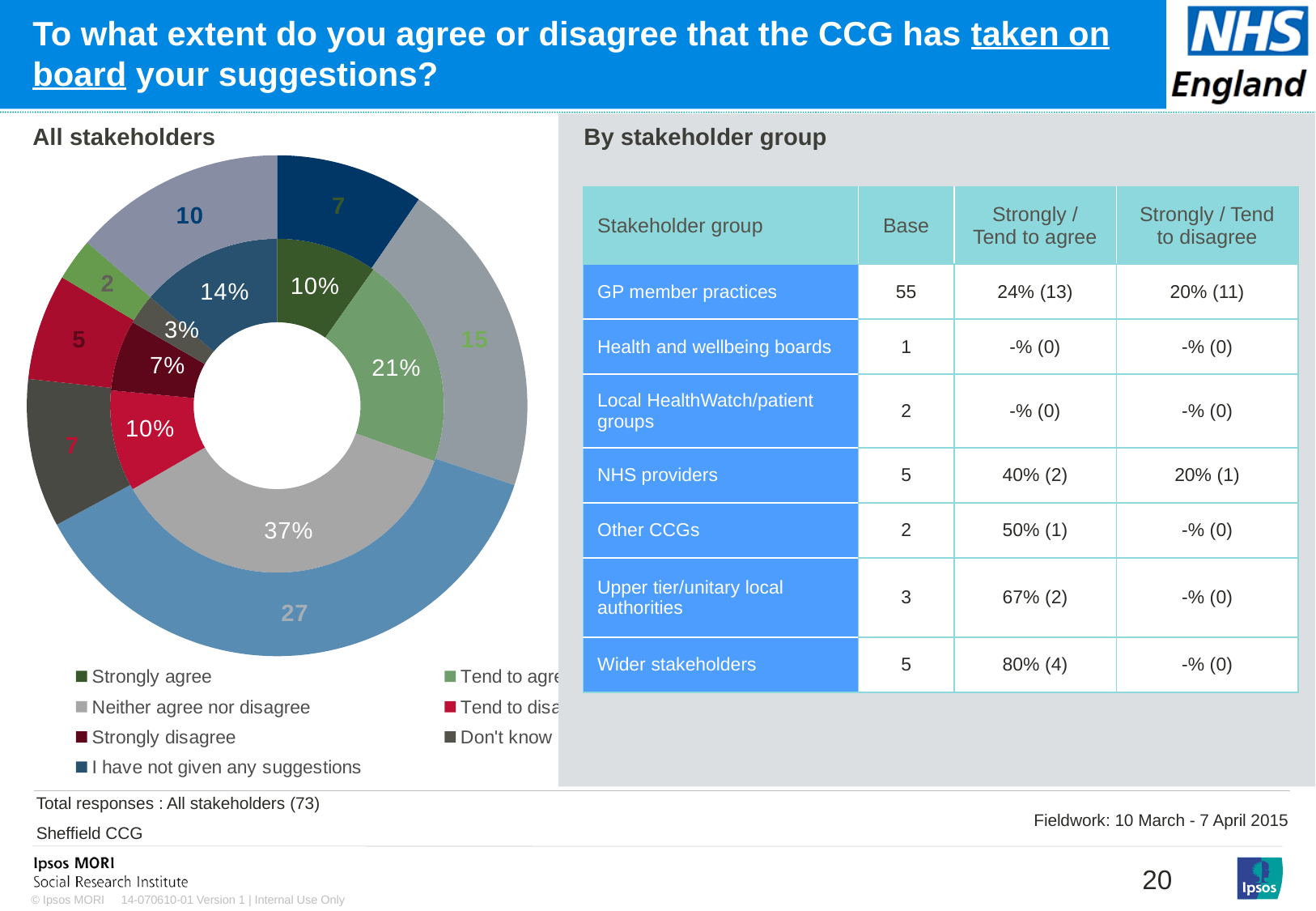
What is the total number of responses stated for the 'All stakeholders' chart? 73 In the 'All stakeholders' chart, which response category has the largest share? Neither agree nor disagree In the 'All stakeholders' chart, what is the difference in percentage points between 'Neither agree nor disagree' and 'Tend to agree'? 16 How many response categories does the legend of the 'All stakeholders' chart list? 7 In the 'All stakeholders' chart, what percentage of respondents said 'Strongly disagree'? 7% In the 'All stakeholders' chart, which response category has the smallest share? Don't know What type of chart is shown under 'All stakeholders'? Doughnut chart In the 'All stakeholders' chart, what percentage of respondents said 'Tend to agree'? 21% In the 'All stakeholders' chart, which is larger: the share for 'Tend to agree' or the share for 'I have not given any suggestions'? Tend to agree In the 'All stakeholders' chart, how many respondents (outer ring count) said 'Neither agree nor disagree'? 27 In the 'All stakeholders' chart, what percentage of respondents said 'I have not given any suggestions'? 14% In the 'All stakeholders' chart, what percentage of respondents said 'Neither agree nor disagree'? 37%